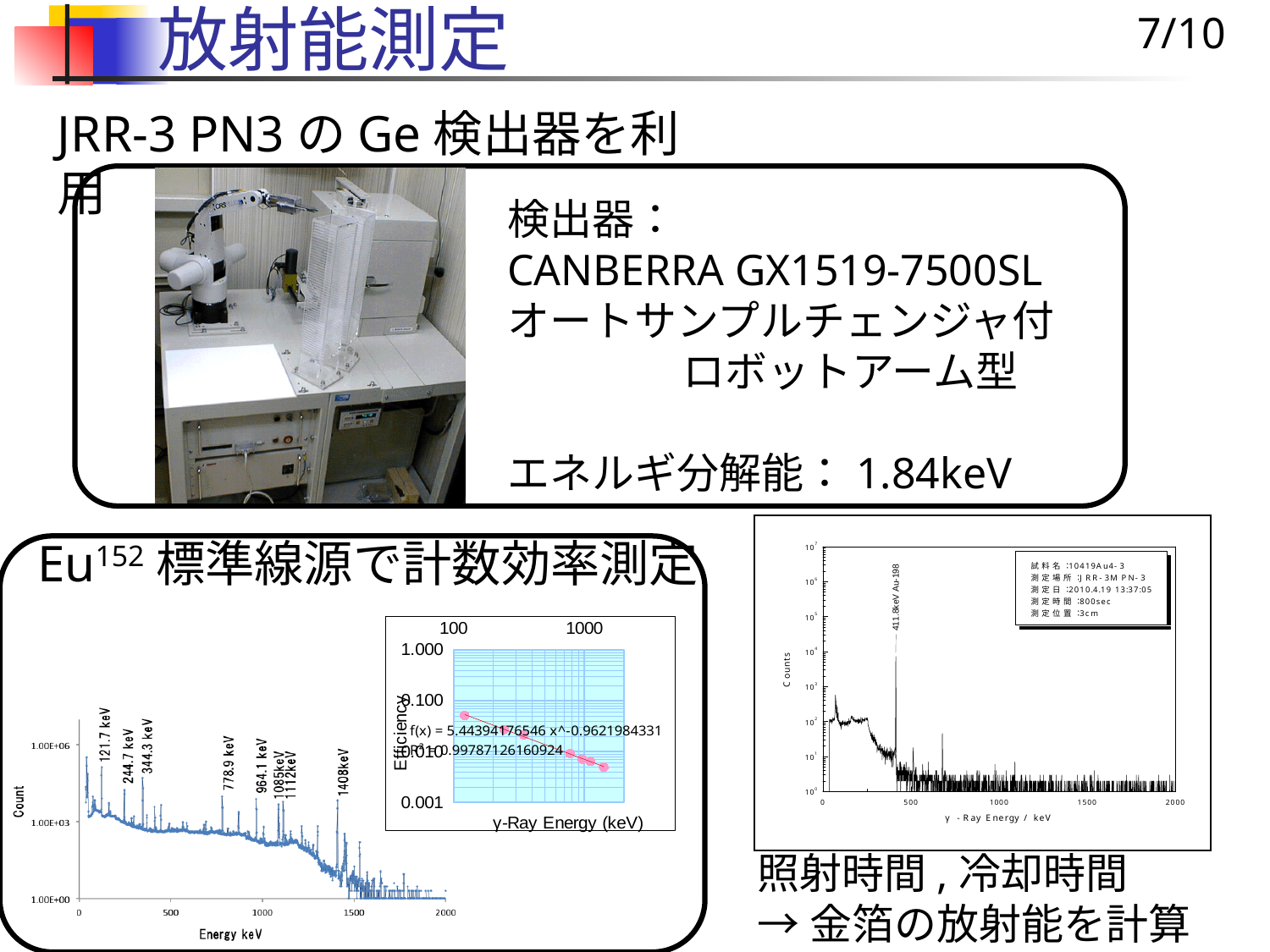
In the Au-198 spectrum chart (right), what measurement time (測定時間) is listed in the text box? 800sec In the efficiency chart (inset in the bottom-left box), what is the label of the x axis? γ-Ray Energy (keV) In the efficiency chart (inset in the bottom-left box), do the plotted efficiency values rise or fall as γ-ray energy increases? fall In the Au-198 spectrum chart (right), what energy is the labeled peak? 411.8keV In the efficiency chart (inset in the bottom-left box), what is the highest tick value shown on the y axis? 1.000 In the Eu-152 spectrum chart (bottom left), what is the energy of the highest-energy labeled peak? 1408keV In the Au-198 spectrum chart (right), what is the maximum tick value on the x axis? 2000 In the efficiency chart (inset in the bottom-left box), what is the R² value printed for the fitted curve? 0.99787126160924 In the Eu-152 spectrum chart (bottom left), how many peaks are labeled with energy values? 8 In the Eu-152 spectrum chart (bottom left), what is the energy of the lowest-energy labeled peak? 121.7 keV In the Eu-152 spectrum chart (bottom left), what is the label of the y axis? Count In the efficiency chart (inset in the bottom-left box), is the efficiency of the leftmost data point (near 100 keV) greater or less than 0.010? greater